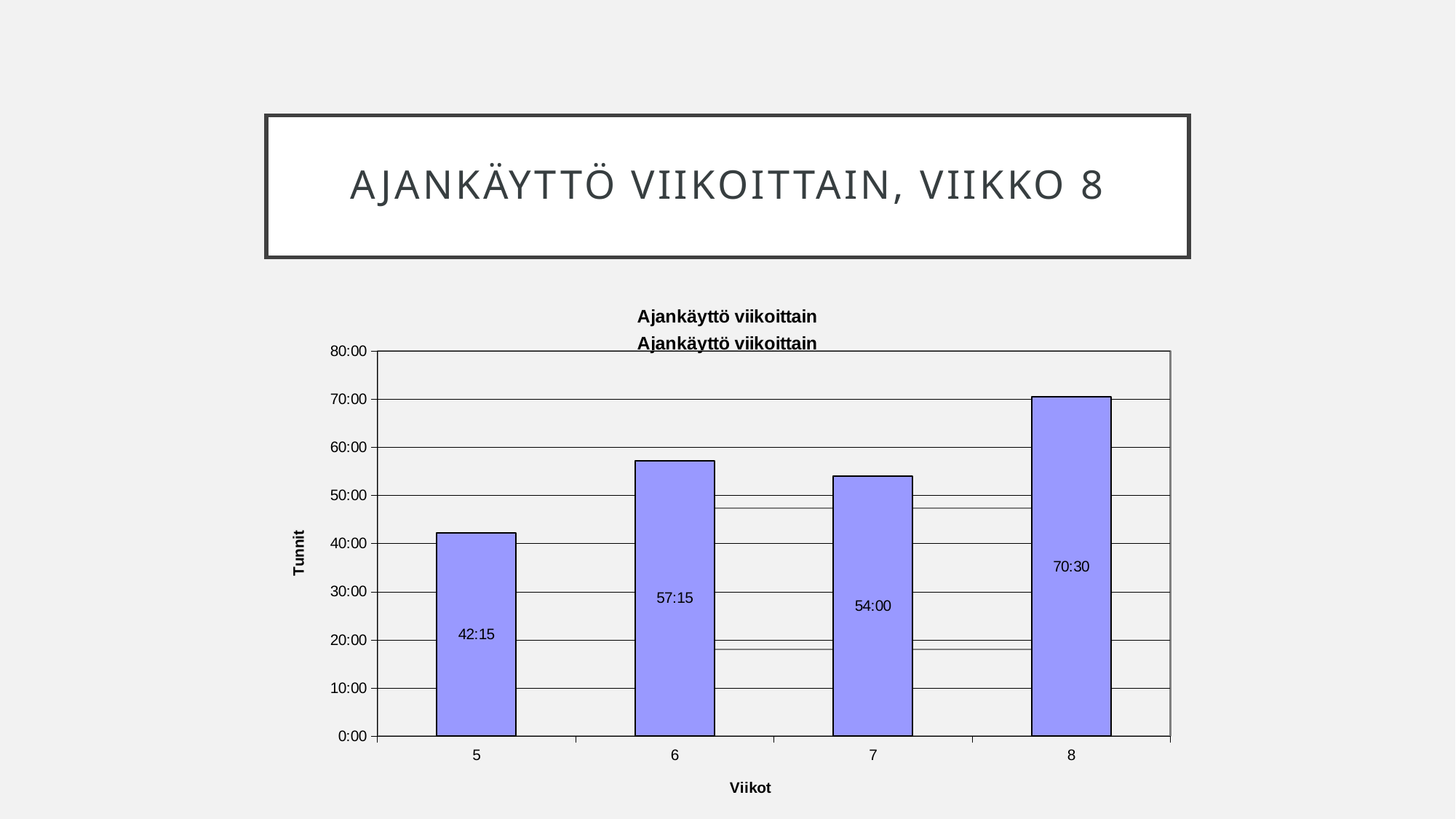
Which week has the highest value? 8 What is the difference between the values for week 8 and week 5? 28:15 Is the value for week 8 greater or less than 60:00? greater What kind of chart is shown on the slide? bar chart Which week has the lowest value? 5 Which is larger, the value for week 6 or the value for week 7? week 6 What is the value for week 8? 70:30 What is the value for week 7? 54:00 What is the value for week 5? 42:15 What is the label of the y axis? Tunnit What is the difference between the values for week 6 and week 7? 3:15 How many weeks are shown on the x axis? 4